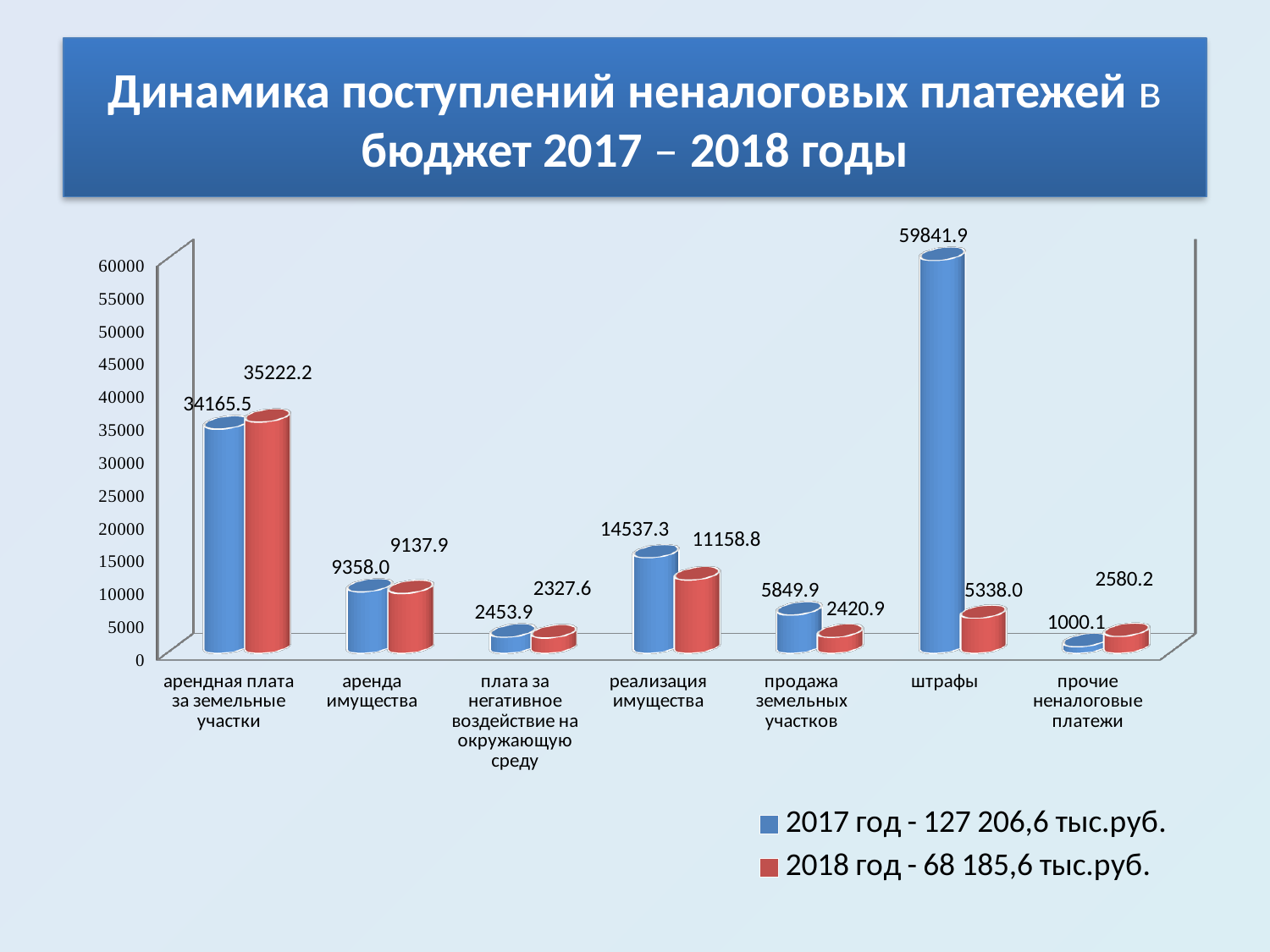
What is the 2017 value for продажа земельных участков? 5849.9 What is the difference between the 2017 and 2018 values for штрафы? 54503.9 What total is given in the legend for 2018 год? 68 185,6 тыс.руб. Which category has the lowest 2018 value? плата за негативное воздействие на окружающую среду What is the 2018 value for реализация имущества? 11158.8 Which is larger for прочие неналоговые платежи, the 2017 value or the 2018 value? 2018 Which category has the highest 2017 value? штрафы What kind of chart is shown on the slide? bar chart Is the 2017 value for арендная плата за земельные участки greater or less than 30000? greater What is the 2017 value for штрафы? 59841.9 How many categories are shown on the x axis? 7 How many series does the legend list? 2